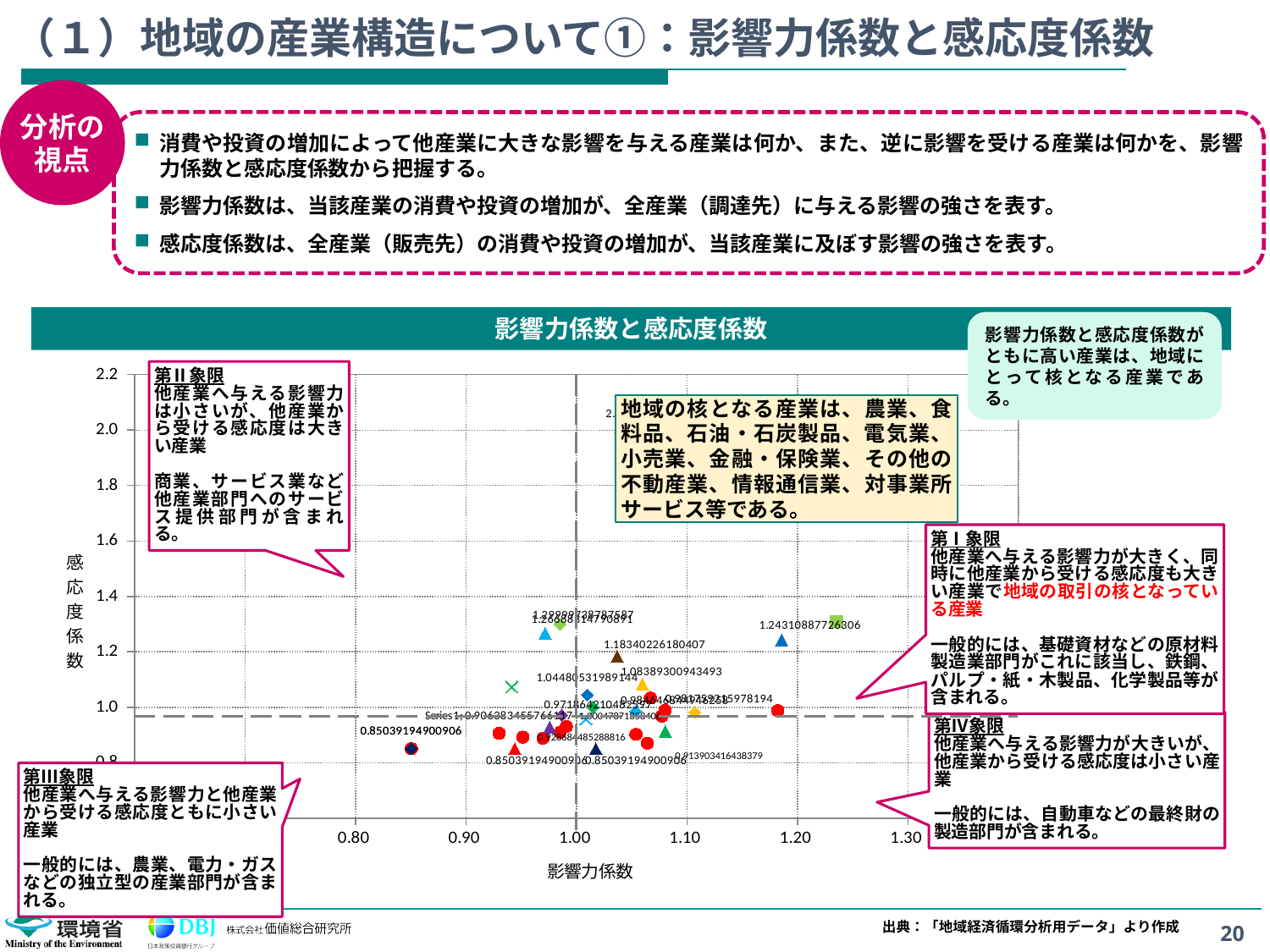
What data label is printed next to the blue triangle point plotted near 影響力係数 1.18? 1.24310887726306 What label is shown on the horizontal axis of the chart? 影響力係数 Is the leftmost point, labelled 0.85039194900906, plotted at an 影響力係数 value greater or less than 0.90? less What is the title of the chart? 影響力係数と感応度係数 What kind of chart is shown on the slide? scatter chart Is the point labelled 1.24310887726306 plotted at an 影響力係数 value greater or less than 1.10? greater Is the point labelled 1.24310887726306 plotted at a 感応度係数 value greater or less than 1.0? greater